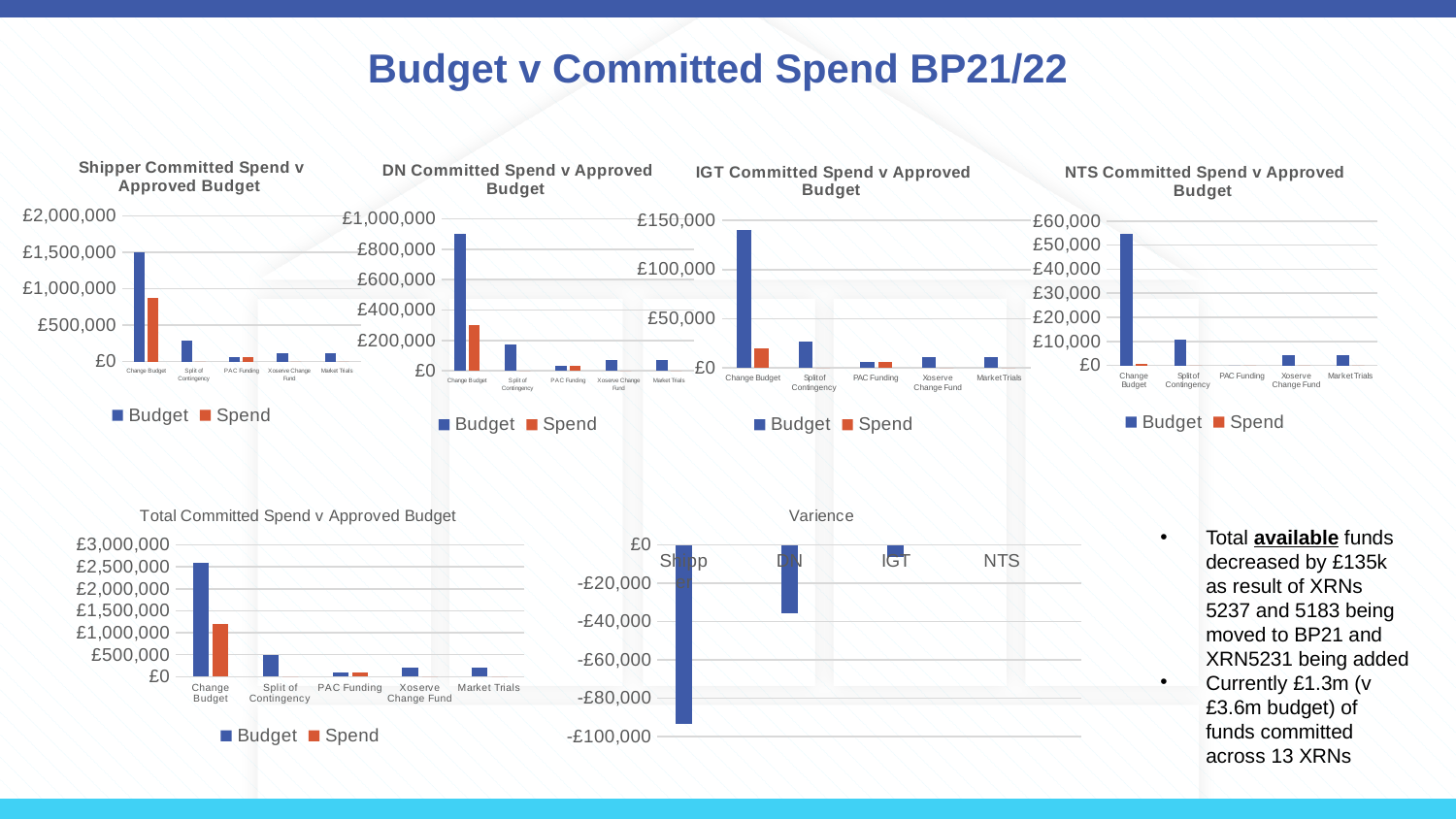
In the 'Varience' chart, is the value for Shipper greater or less than -£80,000? less What kind of chart is the 'Shipper Committed Spend v Approved Budget' chart? bar chart How many series does the legend of the 'Shipper Committed Spend v Approved Budget' chart list? 2 In the 'Total Committed Spend v Approved Budget' chart, which is larger for Change Budget, the Budget or the Spend? Budget In the 'Shipper Committed Spend v Approved Budget' chart, is the Spend value for Change Budget greater or less than £1,000,000? less In the 'DN Committed Spend v Approved Budget' chart, is the Budget value for Change Budget greater or less than £800,000? greater In the 'Varience' chart, which category has the lowest value? Shipper In the 'Shipper Committed Spend v Approved Budget' chart, which category has the highest Budget value? Change Budget What are the two legend entries in the 'NTS Committed Spend v Approved Budget' chart? Budget and Spend How many categories are shown on the x axis of the 'Total Committed Spend v Approved Budget' chart? 5